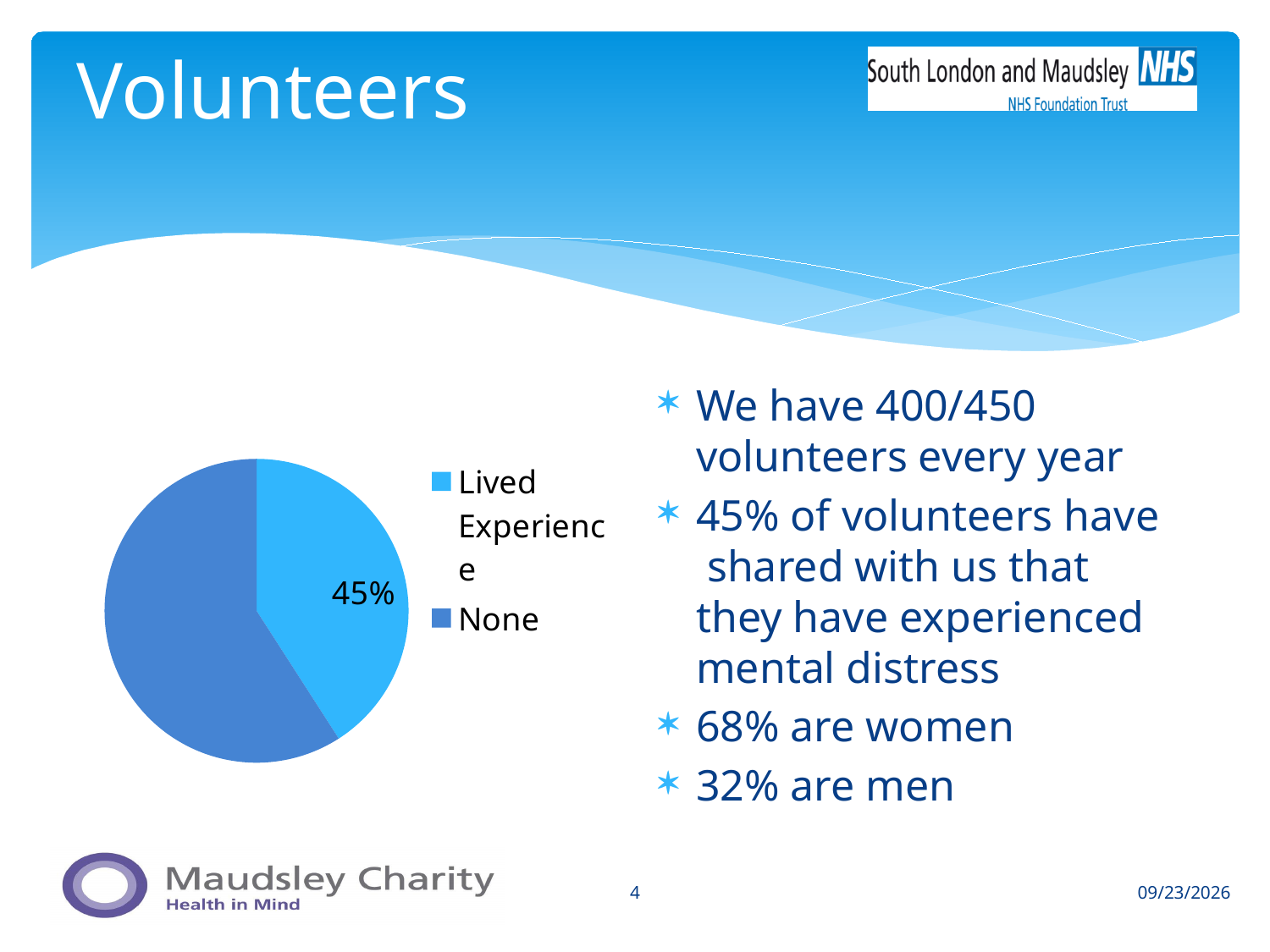
Which slice of the pie chart is shown in the lighter blue colour? Lived Experience How many entries does the chart legend list? 2 What kind of chart is shown on the slide? pie chart What share of the pie does the Lived Experience slice represent? 45% What are the two categories listed in the pie chart legend? Lived Experience and None Which slice of the pie chart is the smallest? Lived Experience How many slices does the pie chart have? 2 Which slice is larger, Lived Experience or None? None What percentage of the pie is labelled for the Lived Experience slice? 45% Is the Lived Experience slice greater or less than half of the pie? less Which slice of the pie chart is the largest? None